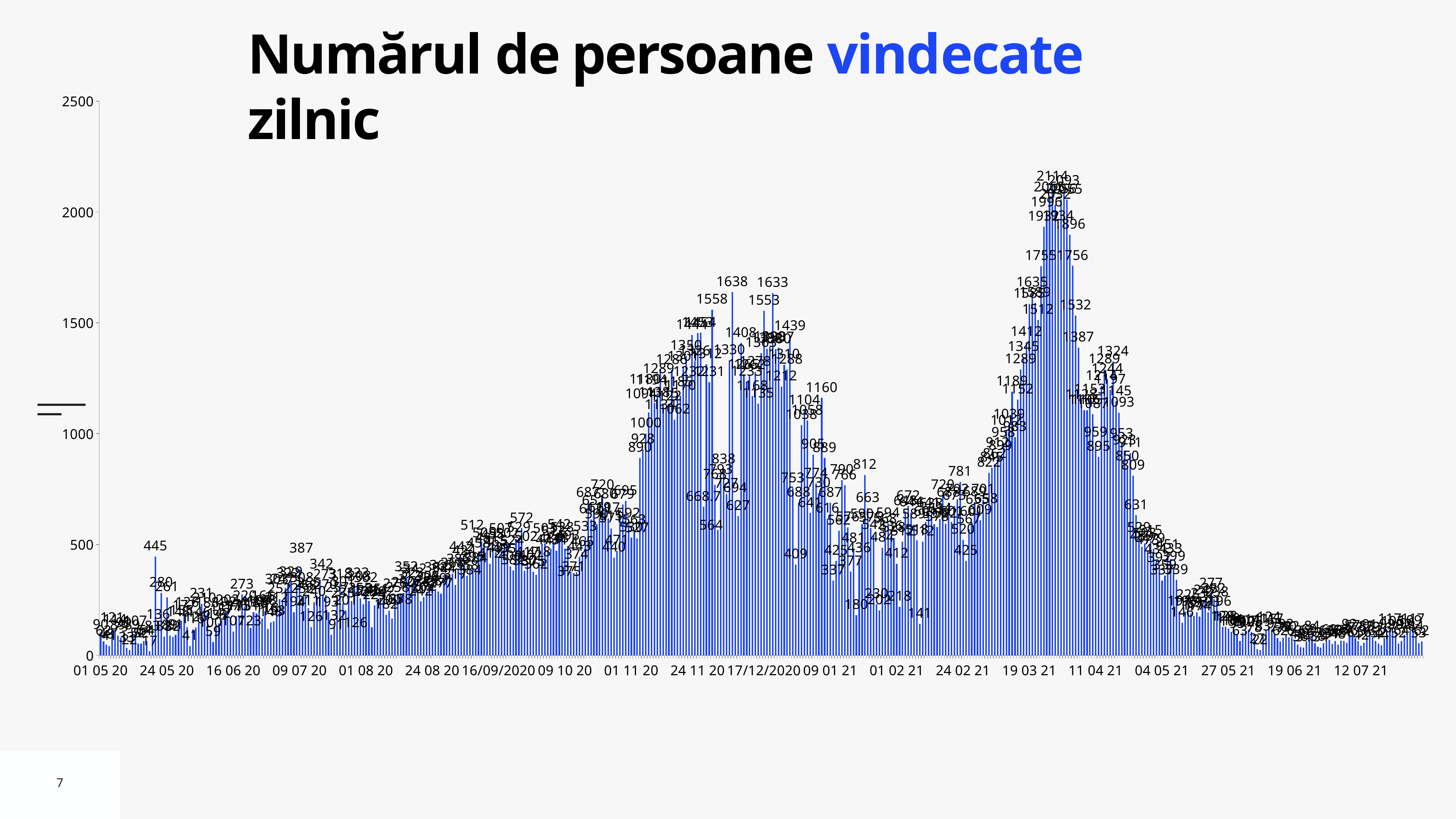
What is the title of the chart? Numărul de persoane vindecate zilnic What is the value of the labelled peak bar near 09 07 20? 387 Which is larger, the labelled peak of 445 near 24 05 20 or the labelled peak of 387 near 09 07 20? 445 What kind of chart is shown on the slide? bar chart What is the difference between the labelled peak of 445 and the labelled peak of 387? 58 Is the value for the bar at 19 06 21 greater or less than 500? less What is the value of the labelled peak bar near 24 05 20? 445 What is the difference between the highest labelled value 2114 and the labelled value 1638? 476 What is the highest tick value shown on the vertical axis? 2500 Do the values rise or fall along the x axis from 19 03 21 to 04 05 21? fall Is the value for the bar at 19 03 21 greater or less than 1000? greater What is the highest value labelled on the chart? 2114